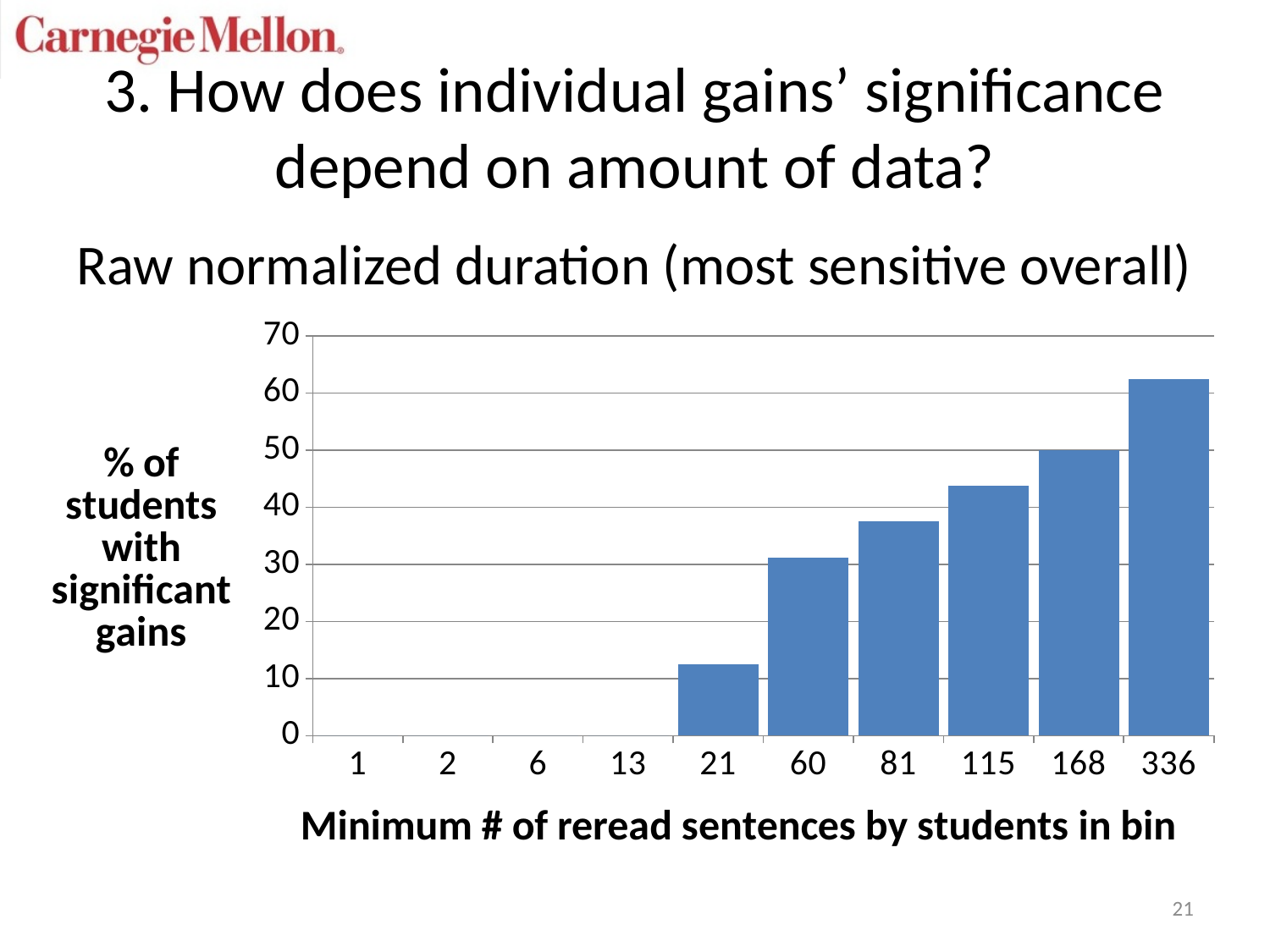
Is the value for the 21 bin greater or less than 20? less What is the title of the x axis of the chart? Minimum # of reread sentences by students in bin Is the value for the 81 bin greater or less than 40? less Do the values generally rise or fall as the minimum number of reread sentences increases along the x axis? rise How many categories are shown on the x axis of the chart? 10 Which category has the highest percentage of students with significant gains? 336 Is the value for the 336 bin greater or less than 60? greater What kind of chart is shown on the slide? bar chart Which has a larger value, the 60 bin or the 115 bin? 115 What does the y axis of the chart measure? % of students with significant gains